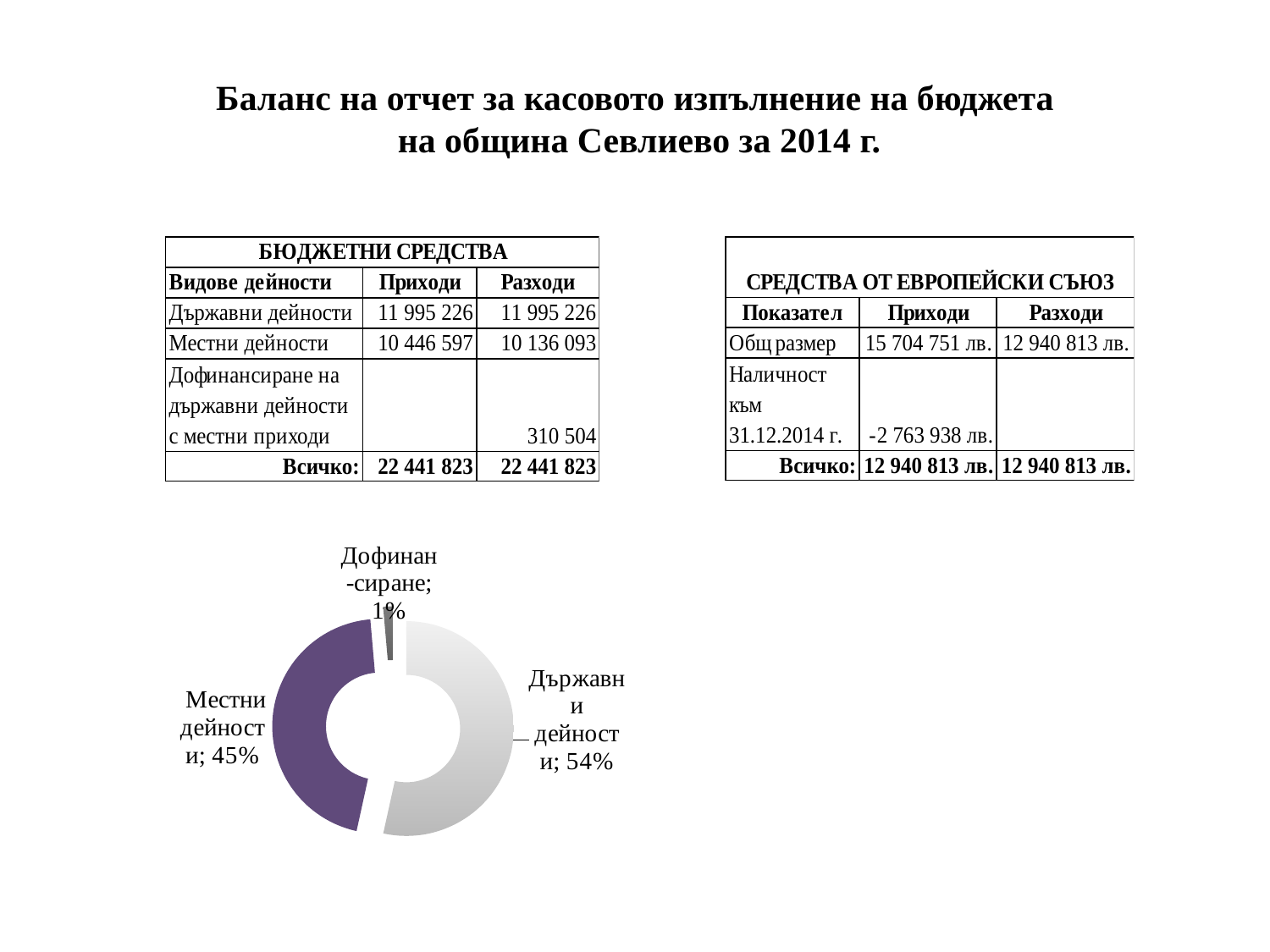
Which slice of the doughnut chart is the largest? Държавни дейности How many slices does the doughnut chart have? 3 Is the share for Държавни дейности greater or less than 50%? greater What share of the doughnut chart is labelled Местни дейности? 45% What share of the doughnut chart is labelled Държавни дейности? 54% What is the difference in percentage points between the Държавни дейности and Местни дейности slices? 9% What kind of chart is shown on the slide? doughnut chart What share of the doughnut chart is labelled Дофинансиране? 1% Which slice of the doughnut chart is coloured purple? Местни дейности Which slice of the doughnut chart is the smallest? Дофинансиране What is the difference in percentage points between the Местни дейности and Дофинансиране slices? 44% In the doughnut chart, which is larger: Държавни дейности or Местни дейности? Държавни дейности